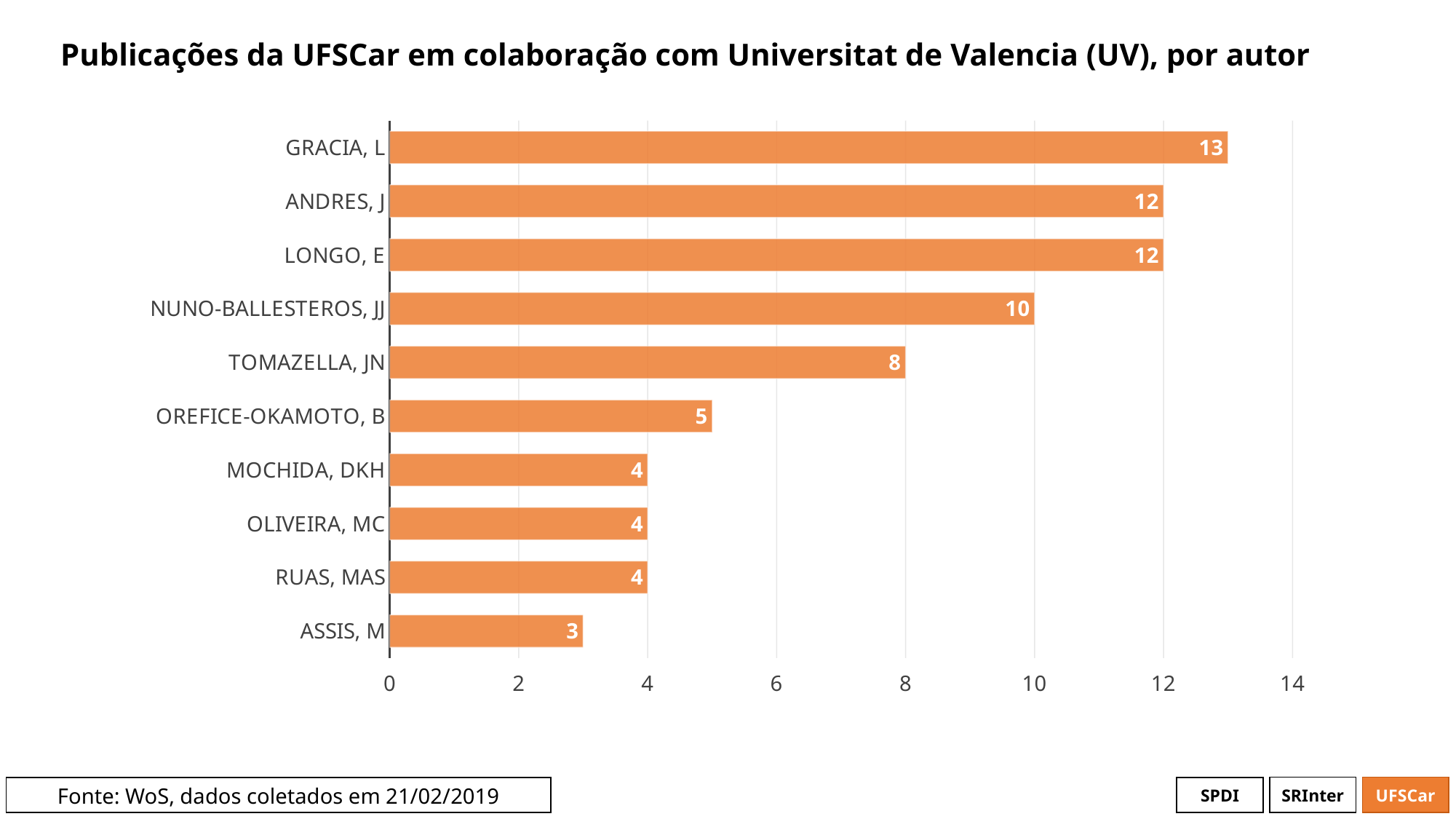
How many authors are shown in the chart? 10 Which is larger, the value for NUNO-BALLESTEROS, JJ or the value for TOMAZELLA, JN? NUNO-BALLESTEROS, JJ What is the difference between the values for TOMAZELLA, JN and ASSIS, M? 5 What is the difference between the values for GRACIA, L and NUNO-BALLESTEROS, JJ? 3 Which author has the lowest number of publications? ASSIS, M What is the source of the data stated on the slide? WoS, dados coletados em 21/02/2019 What is the value for TOMAZELLA, JN? 8 Which author has the highest number of publications? GRACIA, L What kind of chart is shown on the slide? bar chart How many publications does GRACIA, L have? 13 How many authors have a value of 4? 3 What is the value for OREFICE-OKAMOTO, B? 5